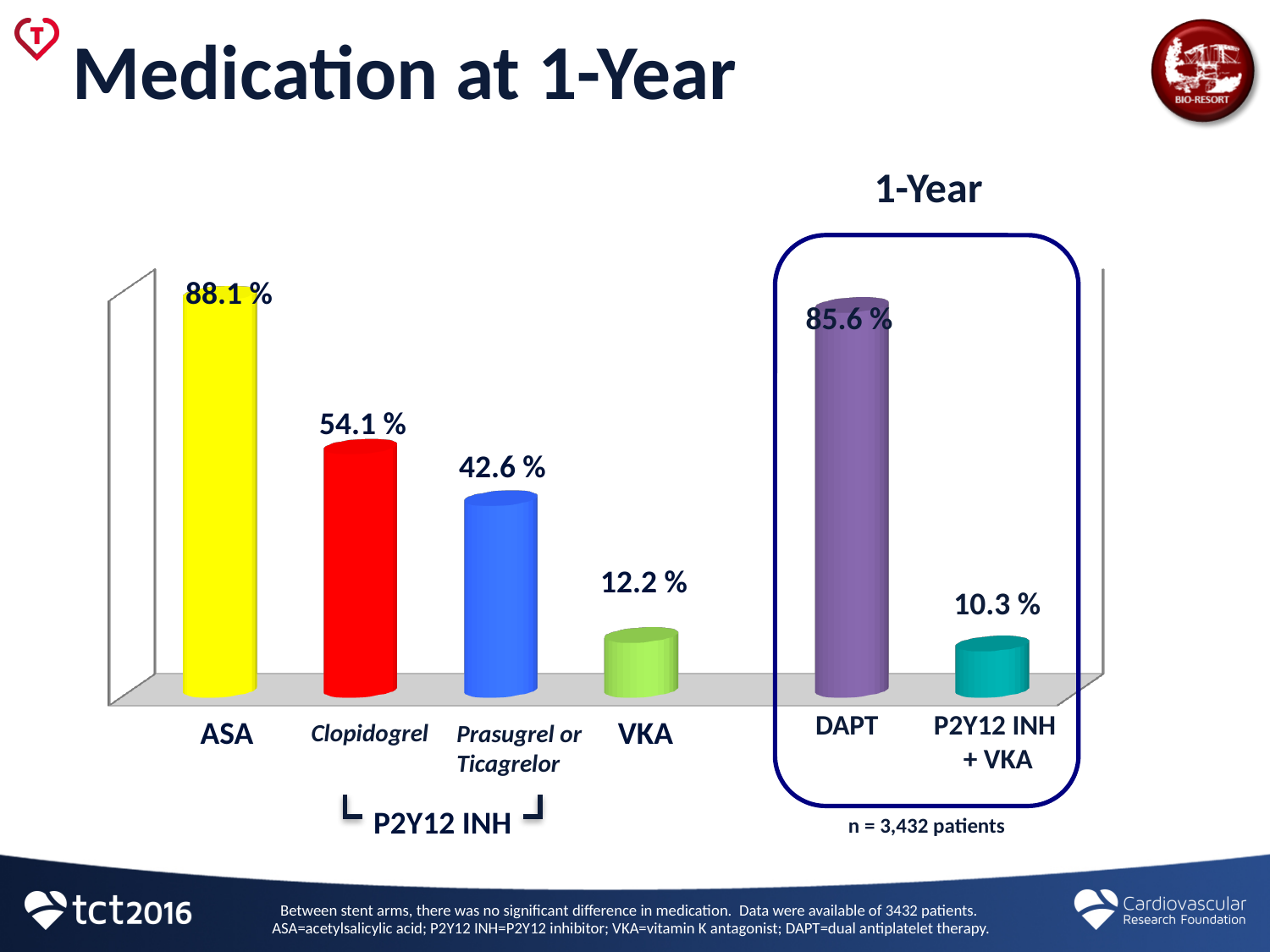
What kind of chart is shown on the slide? Bar chart Which category has the lowest value? P2Y12 INH + VKA What is the difference between the values for ASA and DAPT? 2.5 % Which category has the highest value? ASA What is the difference between the values for Clopidogrel and Prasugrel or Ticagrelor? 11.5 % How many categories are shown in the chart? 6 What is the value for ASA? 88.1 % What is the value for DAPT? 85.6 % What is the value for Clopidogrel? 54.1 % What is the value for Prasugrel or Ticagrelor? 42.6 % What is the value for P2Y12 INH + VKA? 10.3 % Which is larger, the value for VKA or the value for P2Y12 INH + VKA? VKA